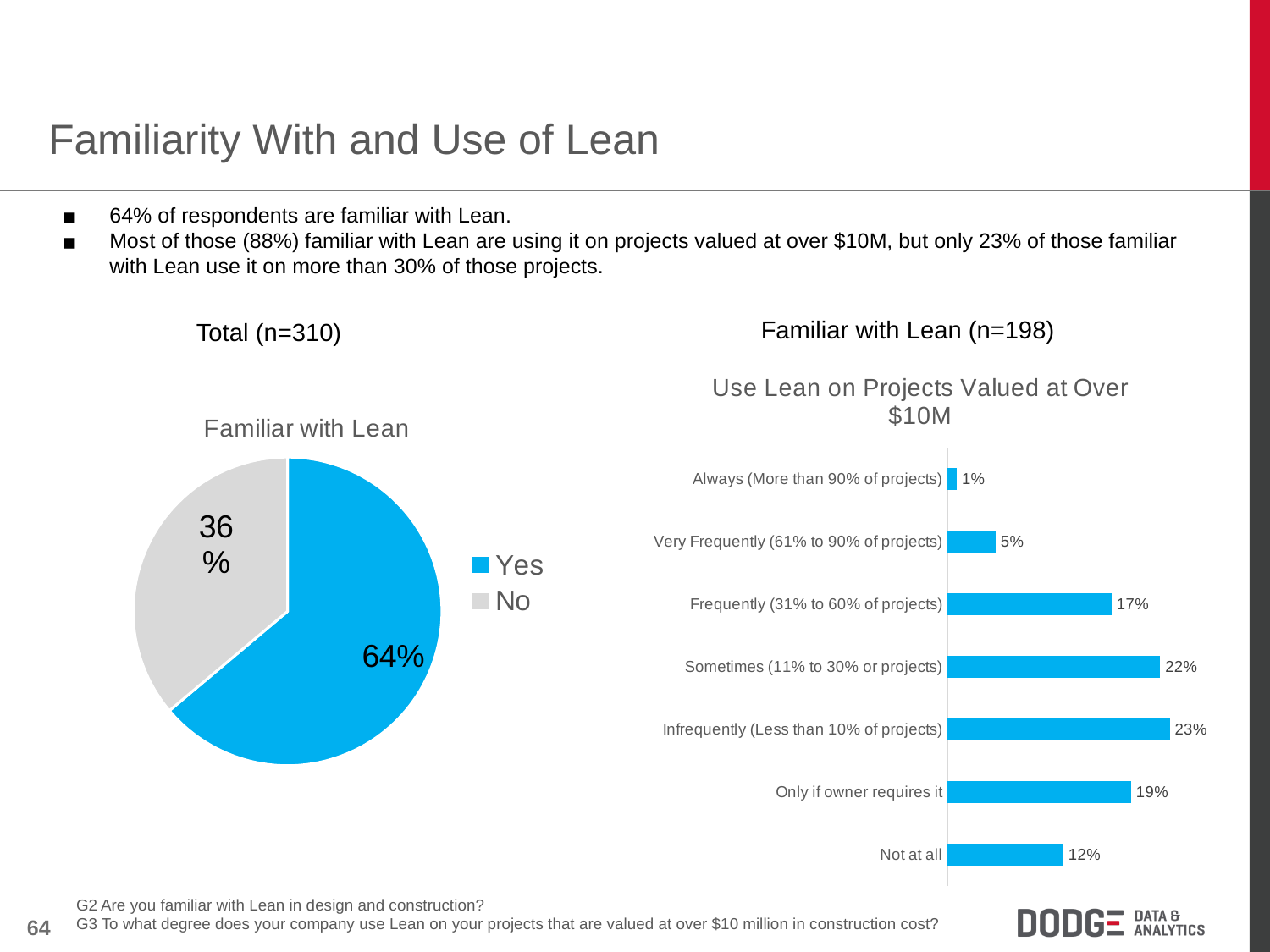
In the 'Familiar with Lean' pie chart, what share of respondents answered Yes? 64% In the 'Use Lean on Projects Valued at Over $10M' chart, what is the difference between 'Only if owner requires it' and 'Very Frequently (61% to 90% of projects)'? 14% In the 'Familiar with Lean' pie chart, what share of respondents answered No? 36% In the 'Use Lean on Projects Valued at Over $10M' chart, which category has the highest value? Infrequently (Less than 10% of projects) How many categories are shown in the 'Use Lean on Projects Valued at Over $10M' chart? 7 What kind of chart is 'Use Lean on Projects Valued at Over $10M'? Bar chart In the 'Use Lean on Projects Valued at Over $10M' chart, what is the value for 'Not at all'? 12% How many entries does the legend of the 'Familiar with Lean' pie chart list? 2 In the 'Use Lean on Projects Valued at Over $10M' chart, what is the value for 'Frequently (31% to 60% of projects)'? 17% What kind of chart is the 'Familiar with Lean' chart on the left? Pie chart In the 'Familiar with Lean' pie chart, what is the difference between the Yes and No shares? 28% In the 'Use Lean on Projects Valued at Over $10M' chart, which category has the lowest value? Always (More than 90% of projects)